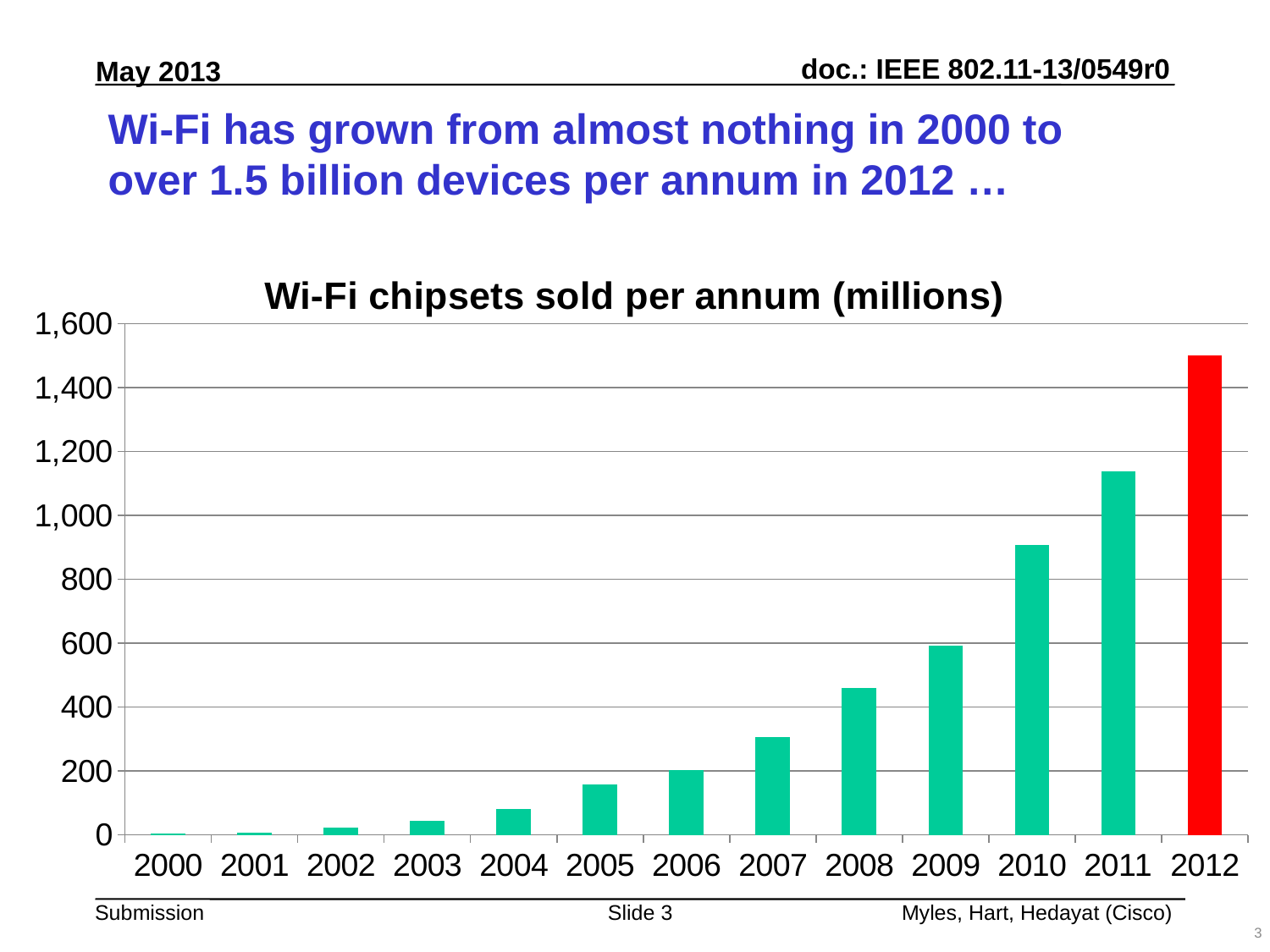
Is the value for 2008 greater or less than 400? greater Which year has the larger value, 2009 or 2010? 2010 Which year has the highest value in the chart? 2012 What is the title of the chart? Wi-Fi chipsets sold per annum (millions) Is the value for 2012 greater or less than 1,400? greater Is the value for 2010 greater or less than 800? greater How many years are shown on the x axis of the chart? 13 Which year has the lowest value in the chart? 2000 Do the values rise or fall from 2000 to 2012? rise What type of chart is shown on the slide? bar chart